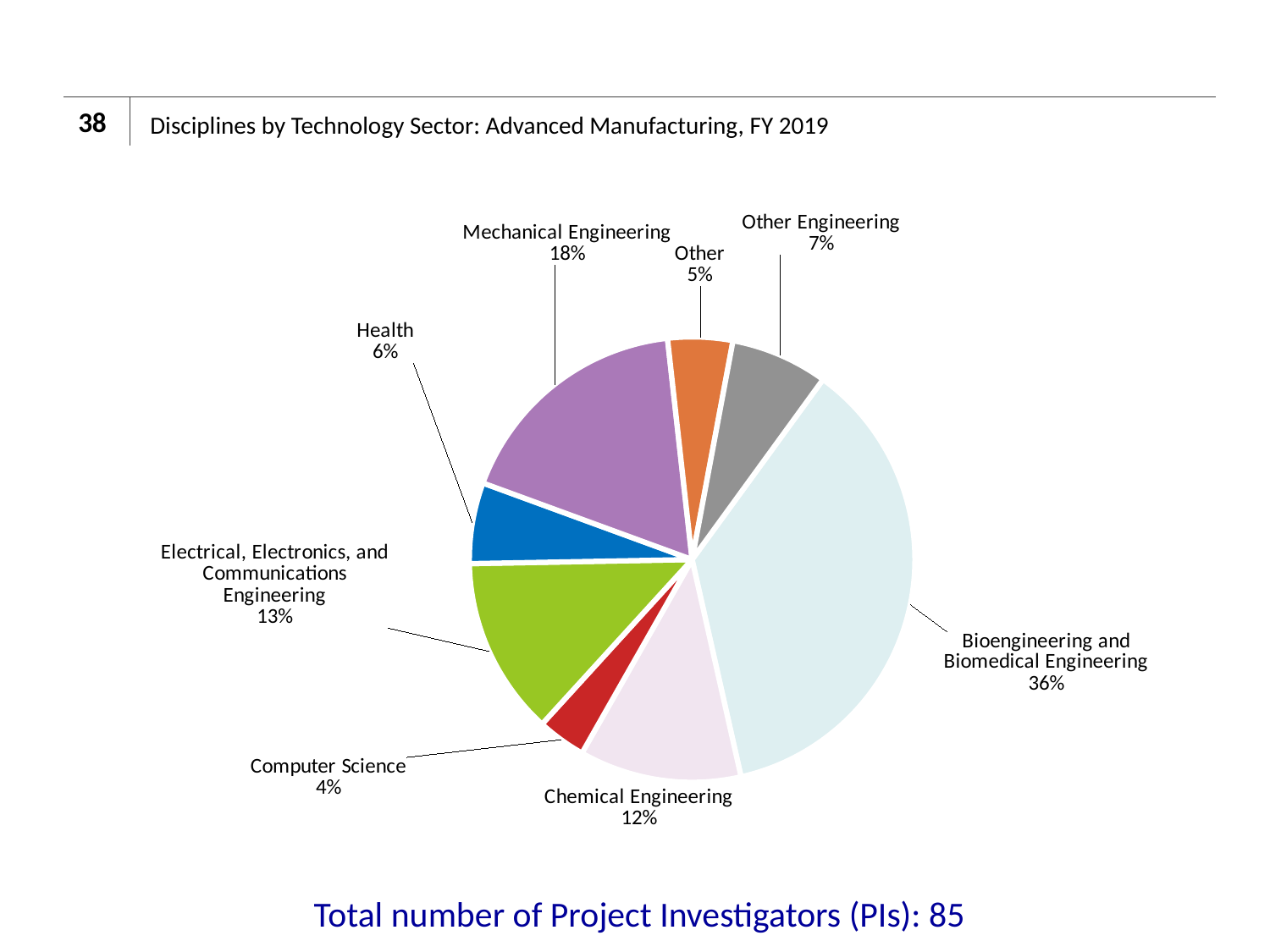
What is the value shown for Electrical, Electronics, and Communications Engineering? 13% Which discipline has the smallest slice of the pie? Computer Science Which is larger, the share for Health or the share for Other Engineering? Other Engineering What is the value shown for Chemical Engineering? 12% How many slices does the pie chart have? 9 What is the difference in percentage points between Mechanical Engineering and Chemical Engineering? 6 What kind of chart is shown on the slide? pie chart What is the title of the slide containing the chart? Disciplines by Technology Sector: Advanced Manufacturing, FY 2019 What is the value shown for Mechanical Engineering? 18% Which discipline has the largest slice of the pie? Bioengineering and Biomedical Engineering What is the total number of Project Investigators (PIs) stated below the chart? 85 What share of the pie does Bioengineering and Biomedical Engineering represent? 36%